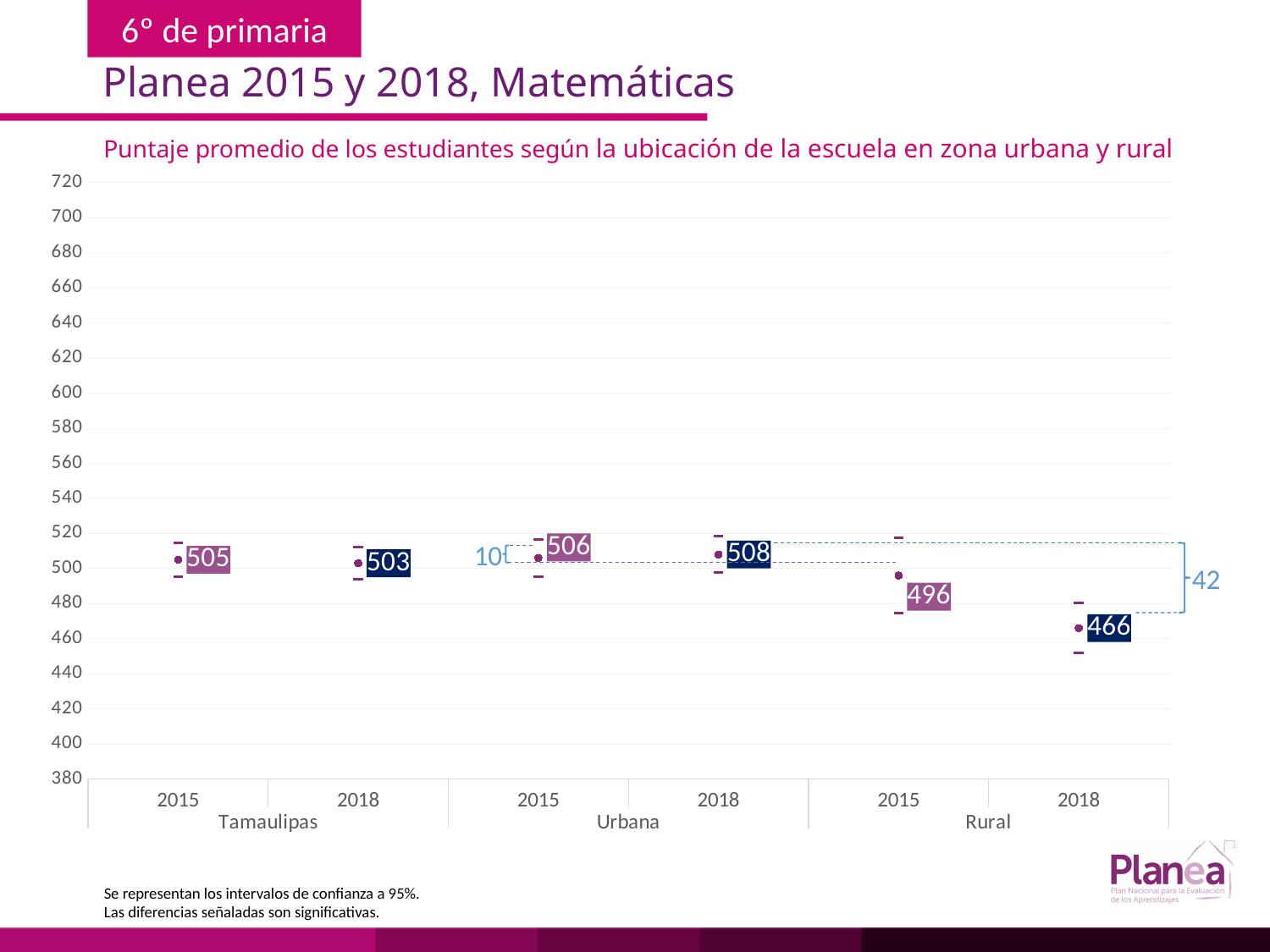
What is the difference between the Rural scores in 2015 and 2018? 30 What is the difference between the Urbana 2018 score and the Rural 2018 score? 42 What is the average score for Urbana schools in 2018? 508 Did the Rural score rise or fall from 2015 to 2018? fall How many data points are plotted on the chart? 6 Is the value for Rural 2018 greater or less than 480? less Which point has the lowest average score? Rural 2018 What is the average score for Tamaulipas in 2015? 505 Which is higher, the Tamaulipas score in 2015 or in 2018? 2015 Which point has the highest average score? Urbana 2018 What is the average score for Rural schools in 2018? 466 What is the subtitle of the chart? Puntaje promedio de los estudiantes según la ubicación de la escuela en zona urbana y rural